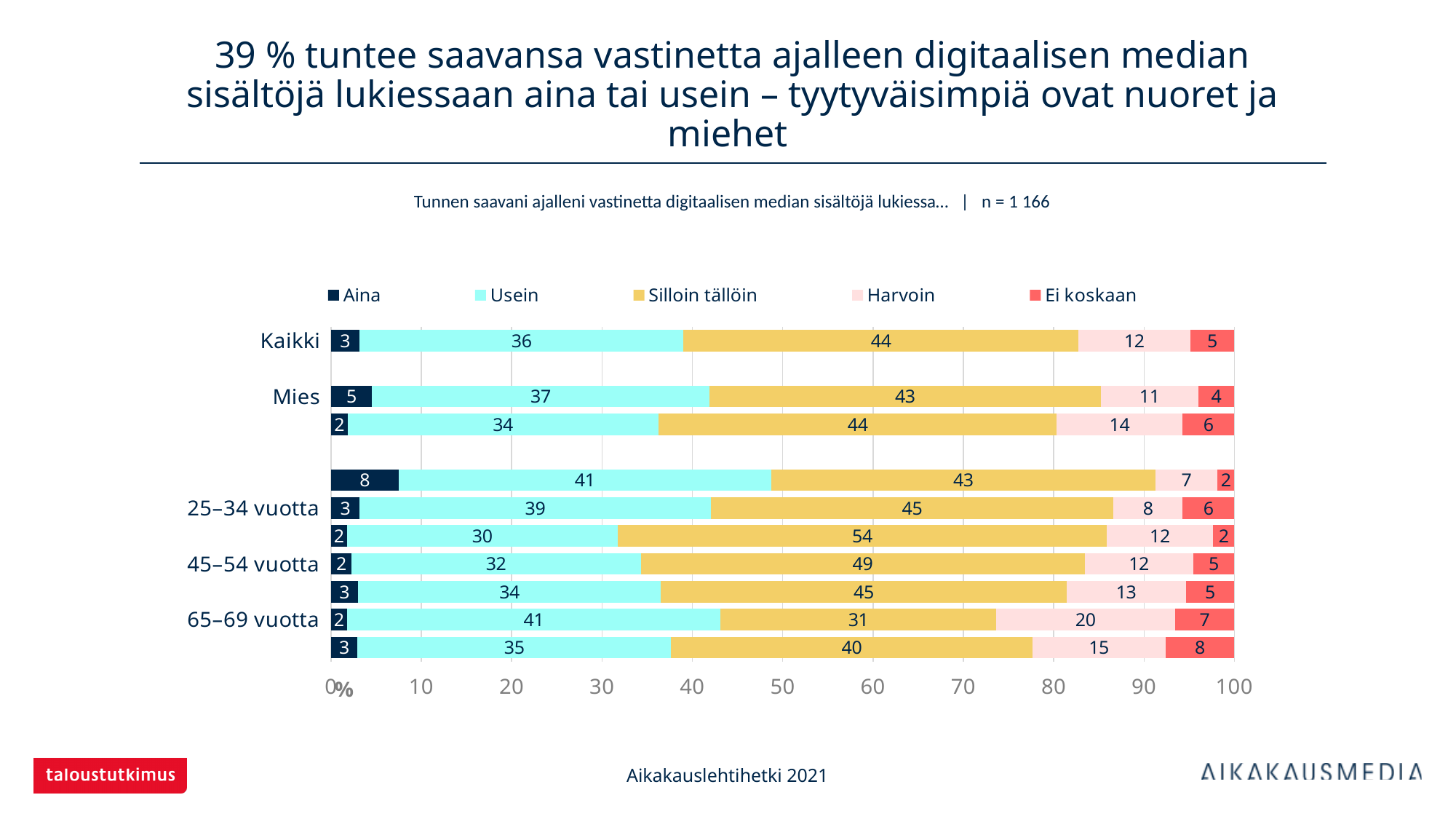
What is the value for "Harvoin" in the 65–69 vuotta bar? 20 What kind of chart is shown on the slide? Stacked bar chart What is the sample size (n) stated on the slide? n = 1 166 Which segment is the largest in the 45–54 vuotta bar? Silloin tällöin Which segment is the smallest in the 65–69 vuotta bar? Aina What is the value for "Ei koskaan" in the 25–34 vuotta bar? 6 Which is larger: the "Harvoin" value for 65–69 vuotta or for 45–54 vuotta? 65–69 vuotta What is the value for "Silloin tällöin" in the Mies bar? 43 What is the value for "Usein" in the Kaikki bar? 36 What is the value for "Aina" in the Mies bar? 5 How many series does the legend list? 5 What is the difference between the "Usein" values for Mies and Kaikki? 1